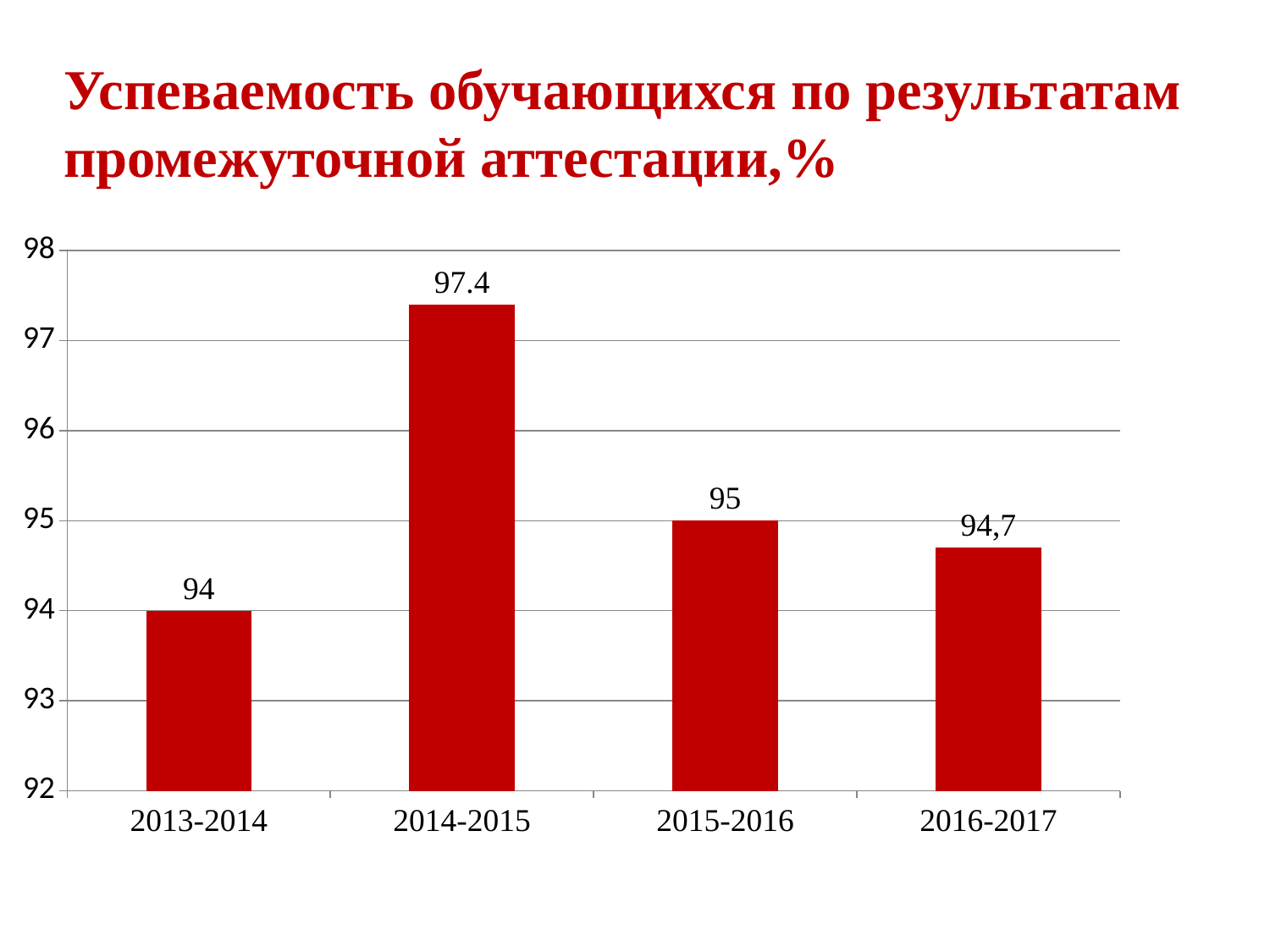
Which academic year has the lowest value? 2013-2014 How many academic years are shown on the chart? 4 What colour are the bars in the chart? red What is the value for 2013-2014? 94 What is the difference between the values for 2014-2015 and 2013-2014? 3.4 Which academic year has the highest value? 2014-2015 What is the value for 2015-2016? 95 Which is larger, the value for 2015-2016 or the value for 2016-2017? 2015-2016 What is the value for 2014-2015? 97.4 What is the value for 2016-2017? 94,7 What kind of chart is shown on the slide? bar chart Is the value for 2014-2015 greater or less than 97? greater